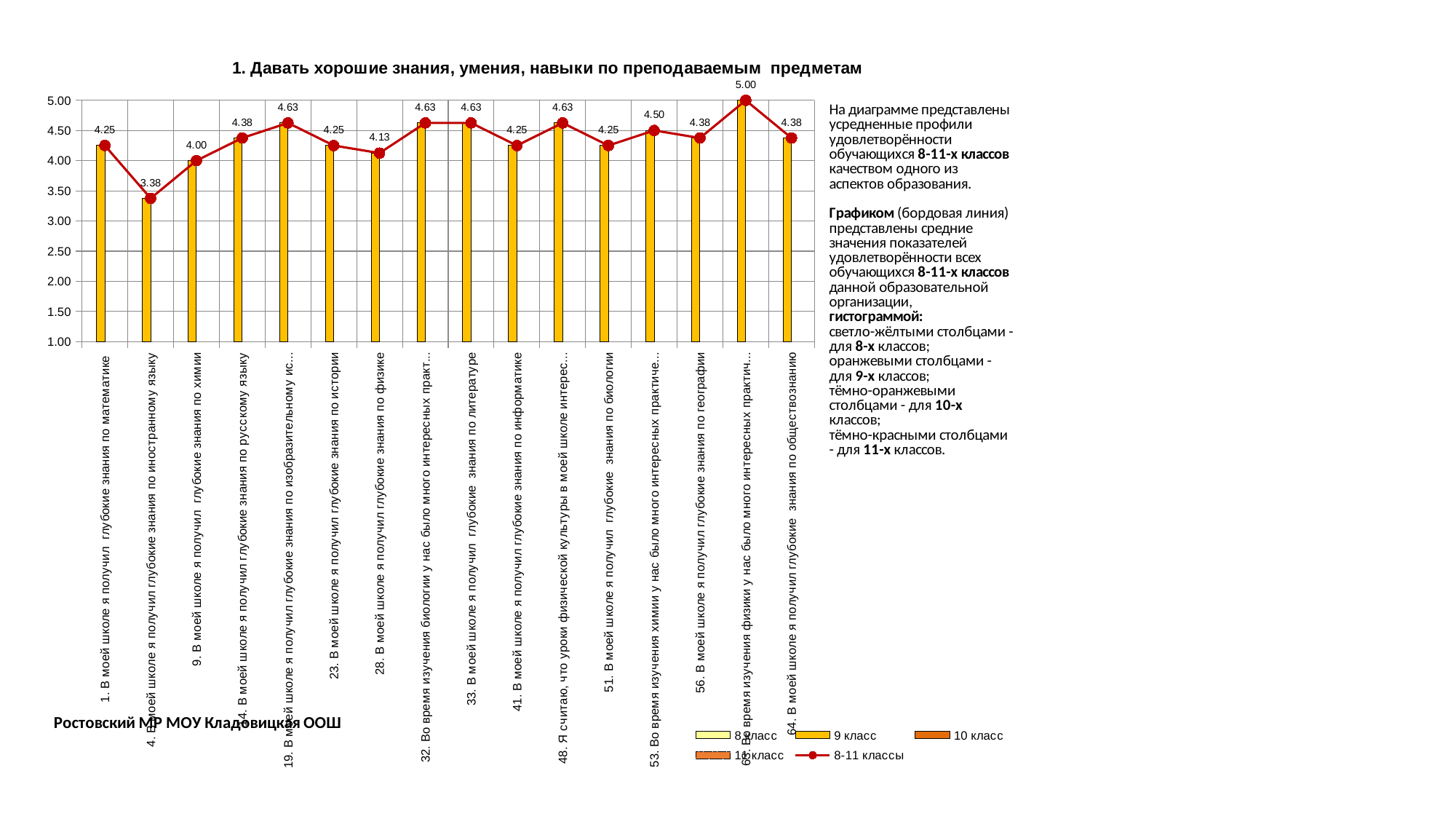
Which category has the lowest value on the 8-11 классы line? 4. В моей школе я получил глубокие знания по иностранному языку How many series does the chart legend list? 5 Which category has the highest value on the 8-11 классы line? 63. Во время изучения физики у нас было много интересных практич... What is the value of the 8-11 классы line for '9. В моей школе я получил глубокие знания по химии'? 4.00 What is the value of the 8-11 классы line for '56. В моей школе я получил глубокие знания по географии'? 4.38 What is the value of the 8-11 классы line for '4. В моей школе я получил глубокие знания по иностранному языку'? 3.38 What is the title of the chart? 1. Давать хорошие знания, умения, навыки по преподаваемым предметам What is the difference between the 8-11 классы values for '33. В моей школе я получил глубокие знания по литературе' and '28. В моей школе я получил глубокие знания по физике'? 0.50 What is the value of the 8-11 классы line for '1. В моей школе я получил глубокие знания по математике'? 4.25 How many categories are shown on the x axis of the chart? 16 Which has a higher 8-11 классы value: '14. В моей школе я получил глубокие знания по русскому языку' or '23. В моей школе я получил глубокие знания по истории'? 14. В моей школе я получил глубокие знания по русскому языку Is the 8-11 классы value for '41. В моей школе я получил глубокие знания по информатике' greater or less than 4.50? less